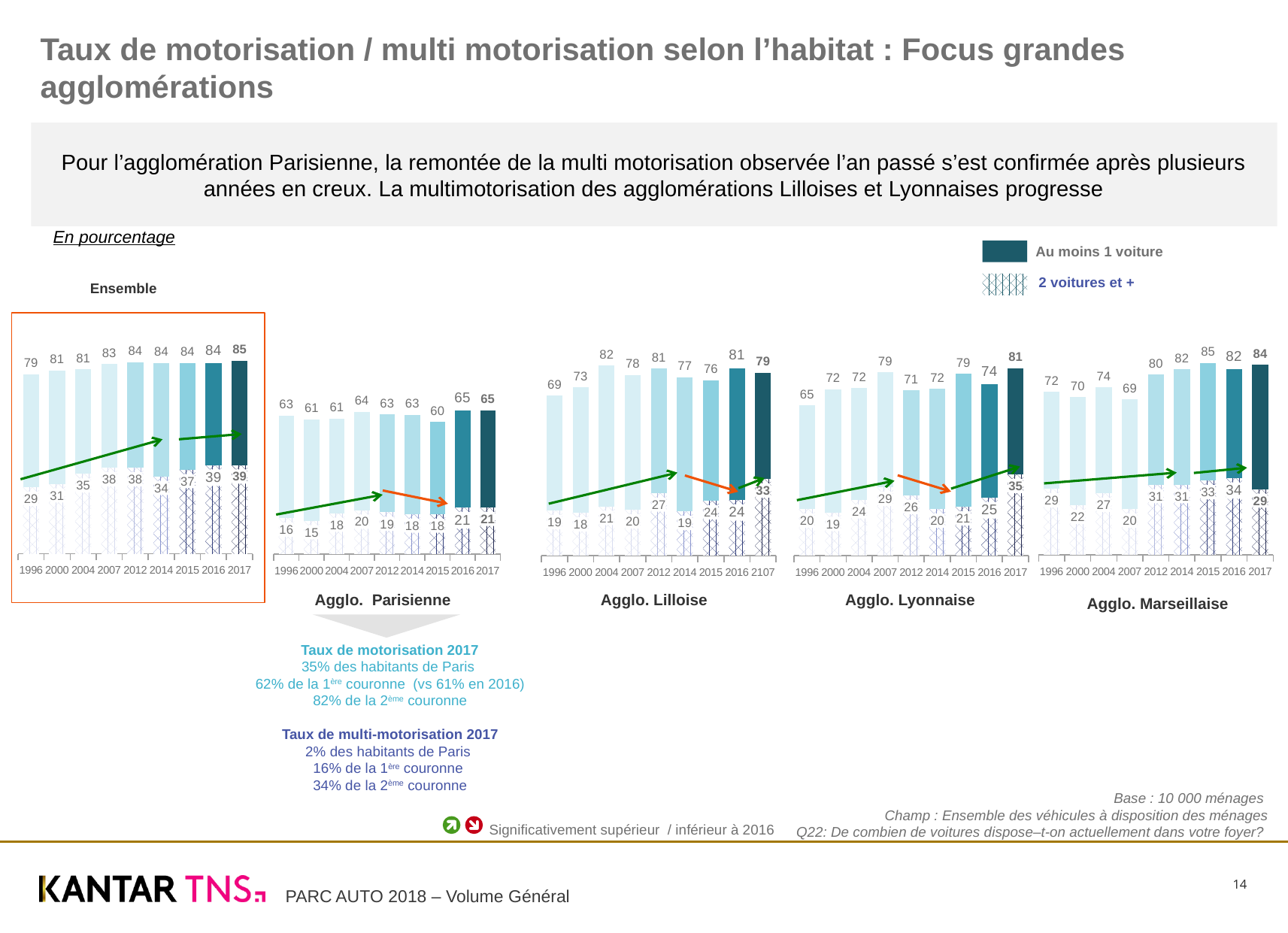
In the Agglo. Parisienne chart, which year has the lowest value for '2 voitures et +'? 2000 How many series does the legend list? 2 In the Agglo. Parisienne chart, what is the value for '2 voitures et +' in 2017? 21 In the Agglo. Lilloise chart, what is the value for '2 voitures et +' in 2017? 33 In the Agglo. Marseillaise chart, what is the value for '2 voitures et +' in 2016? 34 In the Agglo. Marseillaise chart, which year has the highest value for 'Au moins 1 voiture'? 2015 In the Agglo. Lyonnaise chart, what is the difference between the '2 voitures et +' values for 2017 and 2016? 10 What kind of chart is used for the Agglo. Marseillaise data? Bar chart In the Agglo. Lyonnaise chart, what is the value for 'Au moins 1 voiture' in 2017? 81 How many years are shown on the x axis of the Ensemble chart? 9 In the Agglo. Lilloise chart, is the 'Au moins 1 voiture' value for 2004 larger or smaller than the value for 2017? larger In the Ensemble chart, what is the value for 'Au moins 1 voiture' in 2017? 85